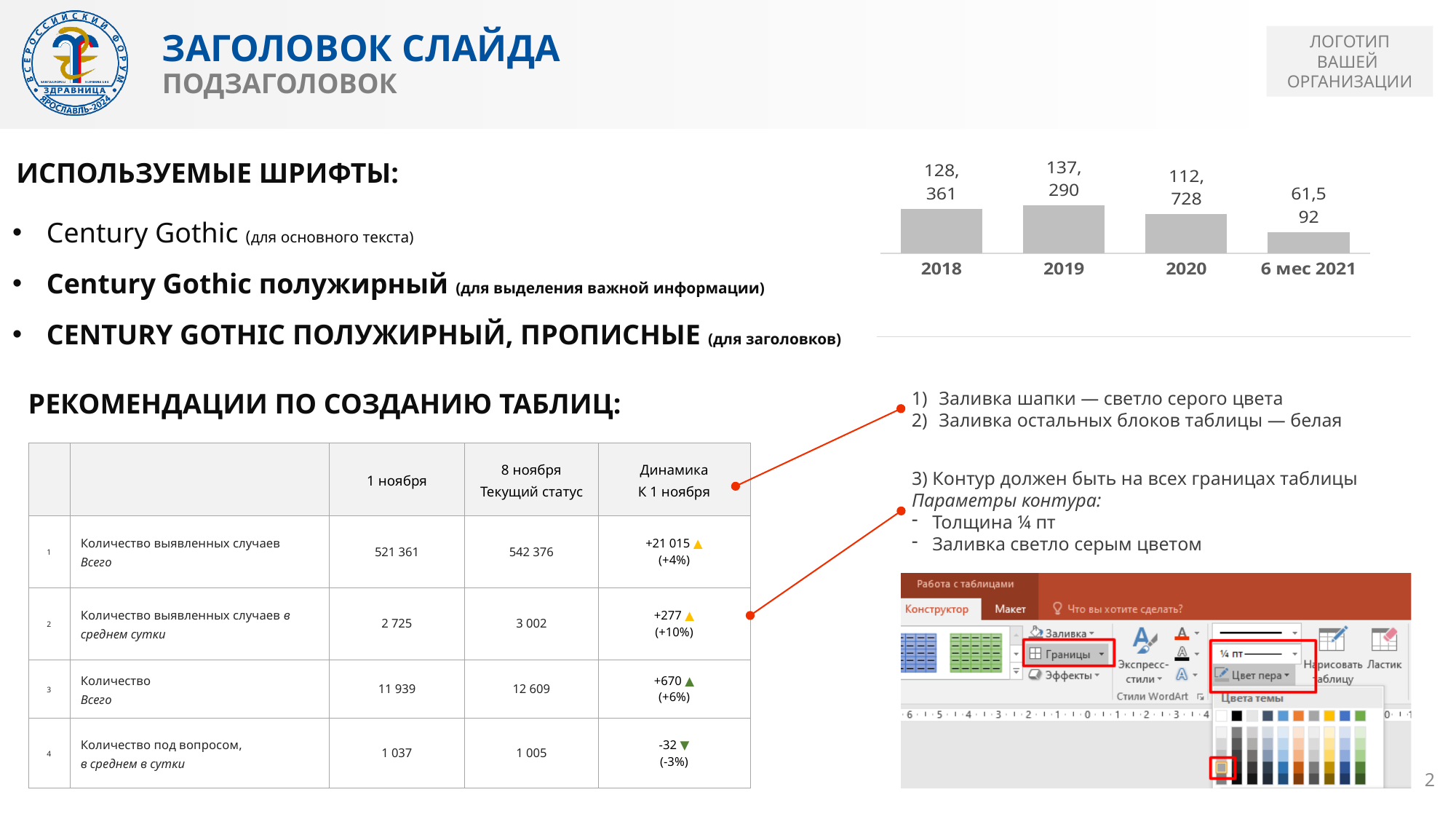
What is the difference between the values for 2020 and '6 мес 2021' in the bar chart? 51,136 What is the difference between the values for 2019 and 2018 in the bar chart? 8,929 Which category has the lowest value in the bar chart? 6 мес 2021 What kind of chart is shown at the top right of the slide? bar chart Which is larger in the bar chart, the value for 2018 or the value for 2020? 2018 What is the value shown for 2019 in the bar chart? 137,290 Which category has the highest value in the bar chart? 2019 What is the value shown for 2018 in the bar chart? 128,361 How many categories are shown in the bar chart? 4 What is the value shown for '6 мес 2021' in the bar chart? 61,592 Do the values in the bar chart rise or fall from 2019 to '6 мес 2021'? fall What is the value shown for 2020 in the bar chart? 112,728